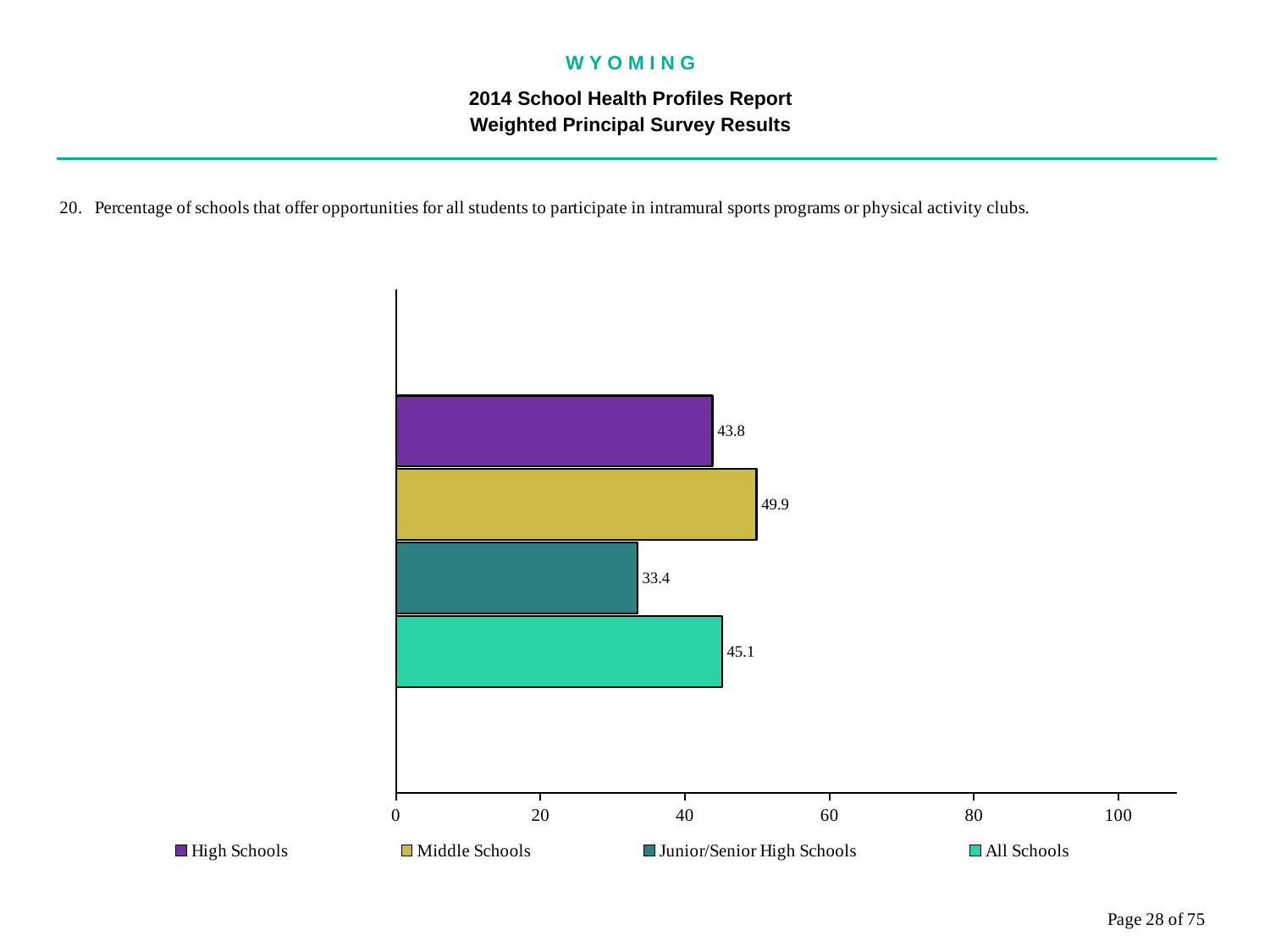
What is the value for Junior/Senior High Schools? 33.4 How many series does the legend list? 4 Which school type has the lowest value? Junior/Senior High Schools What is the difference between the values for Middle Schools and Junior/Senior High Schools? 16.5 Which is larger, the value for High Schools or the value for Junior/Senior High Schools? High Schools What is the value for Middle Schools? 49.9 Is the value for Middle Schools greater or less than 40? greater Which school type has the highest value? Middle Schools What is the difference between the values for All Schools and High Schools? 1.3 What kind of chart is shown on the slide? bar chart What is the value for High Schools? 43.8 What is the value for All Schools? 45.1